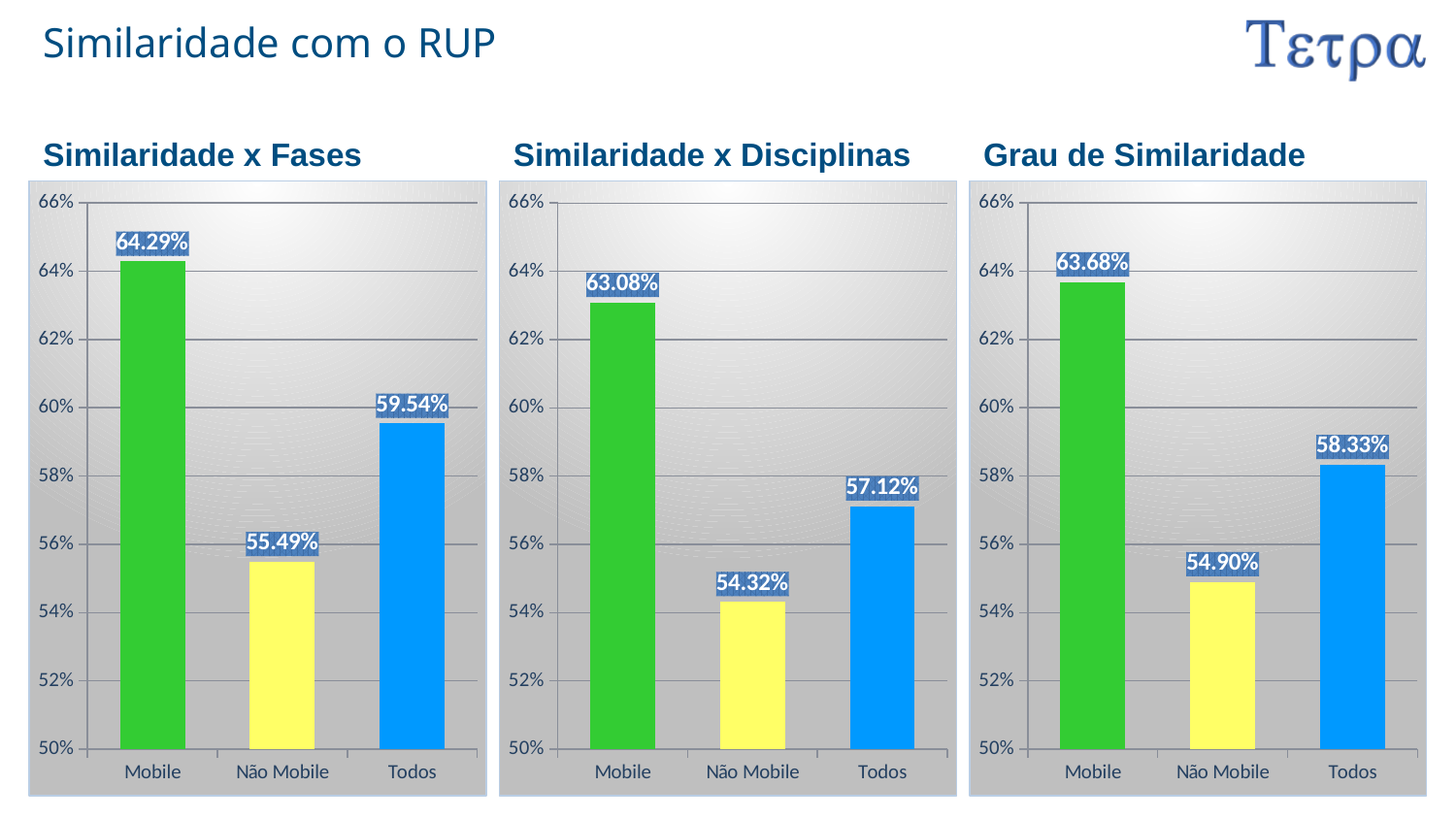
In the 'Similaridade x Fases' chart, which is larger, the value for Todos or the value for Não Mobile? Todos In the 'Similaridade x Disciplinas' chart, what is the value for Não Mobile? 54.32% In the 'Grau de Similaridade' chart, what is the value for Todos? 58.33% In the 'Grau de Similaridade' chart, what is the difference between the Todos and Não Mobile values? 3.43% How many categories are shown in the 'Similaridade x Fases' chart? 3 In the 'Similaridade x Fases' chart, which category has the lowest value? Não Mobile In the 'Similaridade x Fases' chart, what is the value for Mobile? 64.29% In the 'Grau de Similaridade' chart, which category has the highest value? Mobile In the 'Similaridade x Disciplinas' chart, is the value for Todos greater or less than 56%? greater In the 'Similaridade x Disciplinas' chart, what is the difference between the Mobile and Todos values? 5.96% In the 'Similaridade x Disciplinas' chart, what colour is the Não Mobile bar? yellow What kind of chart is the 'Grau de Similaridade' chart? bar chart